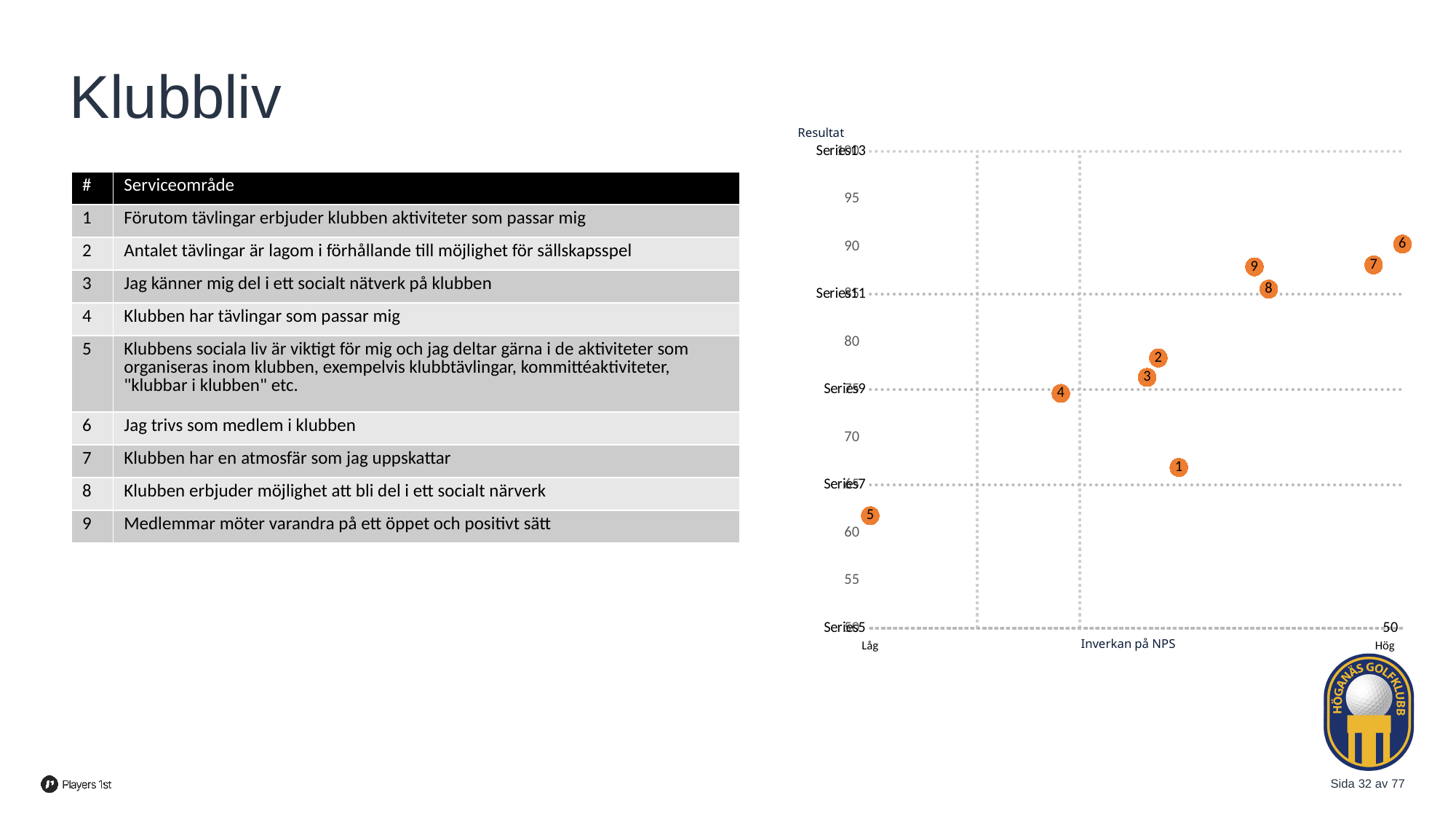
How many data points are plotted in the chart? 9 Which has a higher Resultat value, point 4 or point 5? point 4 What is the label of the horizontal axis of the chart? Inverkan på NPS What kind of chart is shown on the slide? scatter chart Which numbered point has the lowest Resultat value in the chart? 5 What is the label of the vertical axis of the chart? Resultat Is the Resultat value for point 6 greater or less than 85? greater Is the Resultat value for point 5 greater or less than 65? less Is the Resultat value for point 4 greater or less than 80? less Which has a higher Resultat value, point 9 or point 1? point 9 Which numbered point has the highest Resultat value in the chart? 6